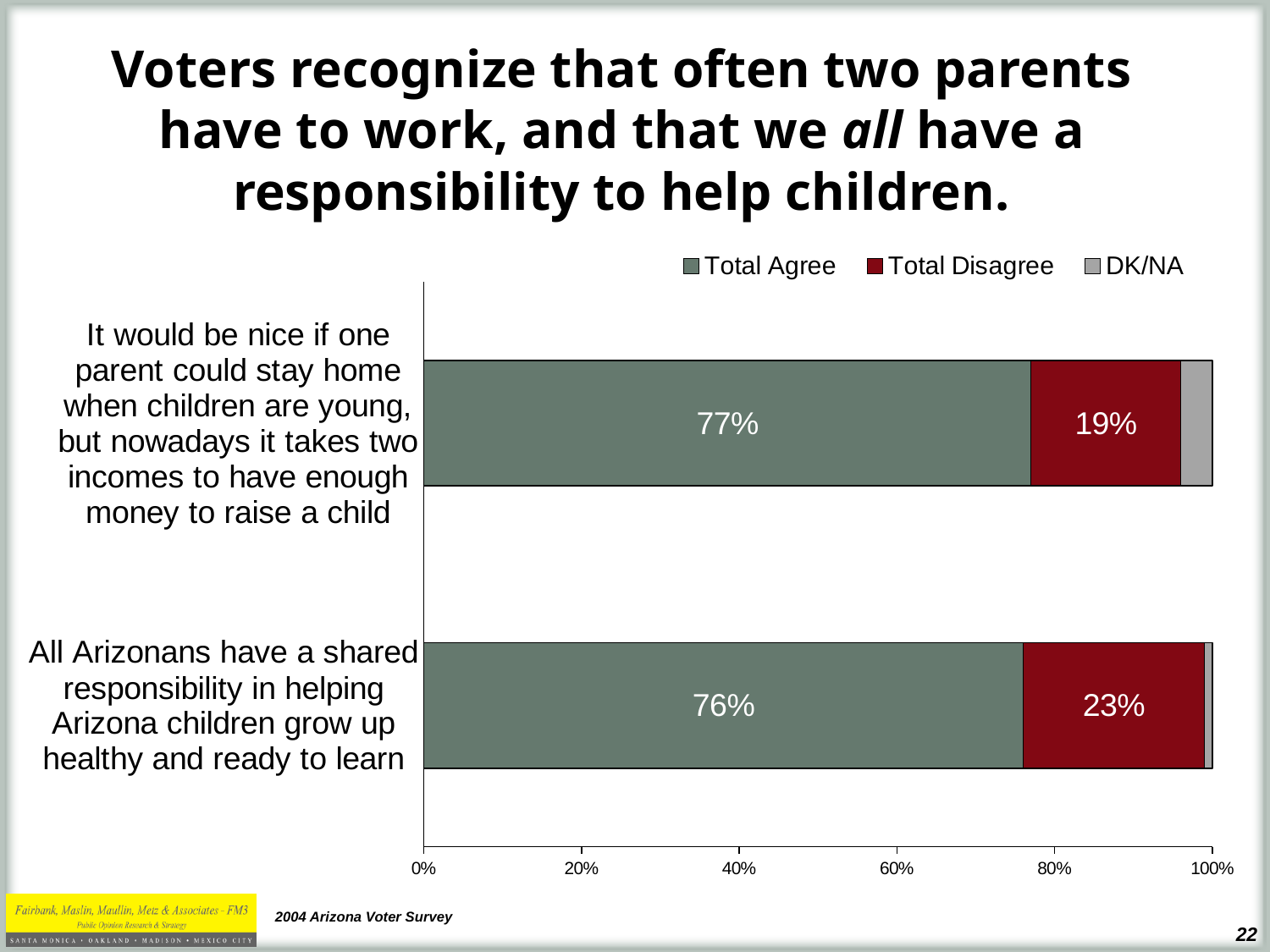
What are the three legend entries in the chart? Total Agree, Total Disagree, DK/NA How many statements are shown in the chart? 2 Which statement has the lower Total Agree percentage? All Arizonans have a shared responsibility in helping Arizona children grow up healthy and ready to learn What is the difference in Total Disagree percentage between the shared responsibility statement and the two incomes statement? 4 percentage points What percentage of voters totally agree that it would be nice if one parent could stay home when children are young, but nowadays it takes two incomes to have enough money to raise a child? 77% What percentage of voters totally disagree that all Arizonans have a shared responsibility in helping Arizona children grow up healthy and ready to learn? 23% Which statement has the higher Total Disagree percentage? All Arizonans have a shared responsibility in helping Arizona children grow up healthy and ready to learn How many series does the legend list? 3 What percentage of voters totally agree that all Arizonans have a shared responsibility in helping Arizona children grow up healthy and ready to learn? 76% What percentage of voters totally disagree that it would be nice if one parent could stay home when children are young, but nowadays it takes two incomes to raise a child? 19% What kind of chart is shown on the slide? Stacked bar chart Is the Total Agree percentage higher for the two incomes statement or the shared responsibility statement? The two incomes statement